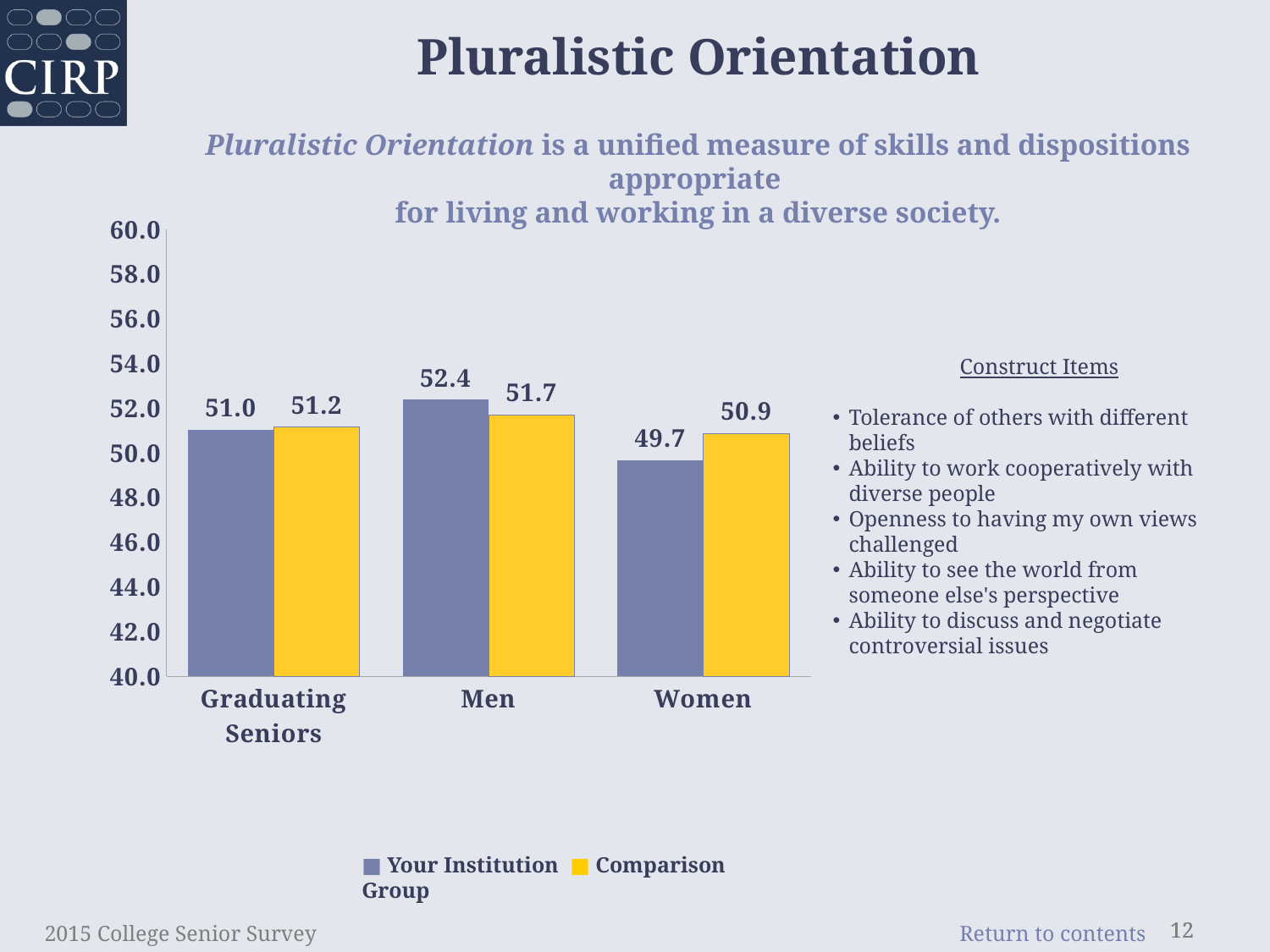
How many series does the legend list? 2 For Men, which is larger: Your Institution or Comparison Group? Your Institution What is the Your Institution value for Graduating Seniors? 51.0 What is the difference between the Comparison Group and Your Institution values for Women? 1.2 Is the Your Institution value for Women greater or less than 50.0? less What kind of chart is shown on the slide? bar chart What is the Your Institution value for Men? 52.4 Which category has the lowest Your Institution value? Women Which category has the highest Your Institution value? Men What is the Comparison Group value for Women? 50.9 How many categories are shown on the x axis? 3 What colour are the Comparison Group bars? yellow